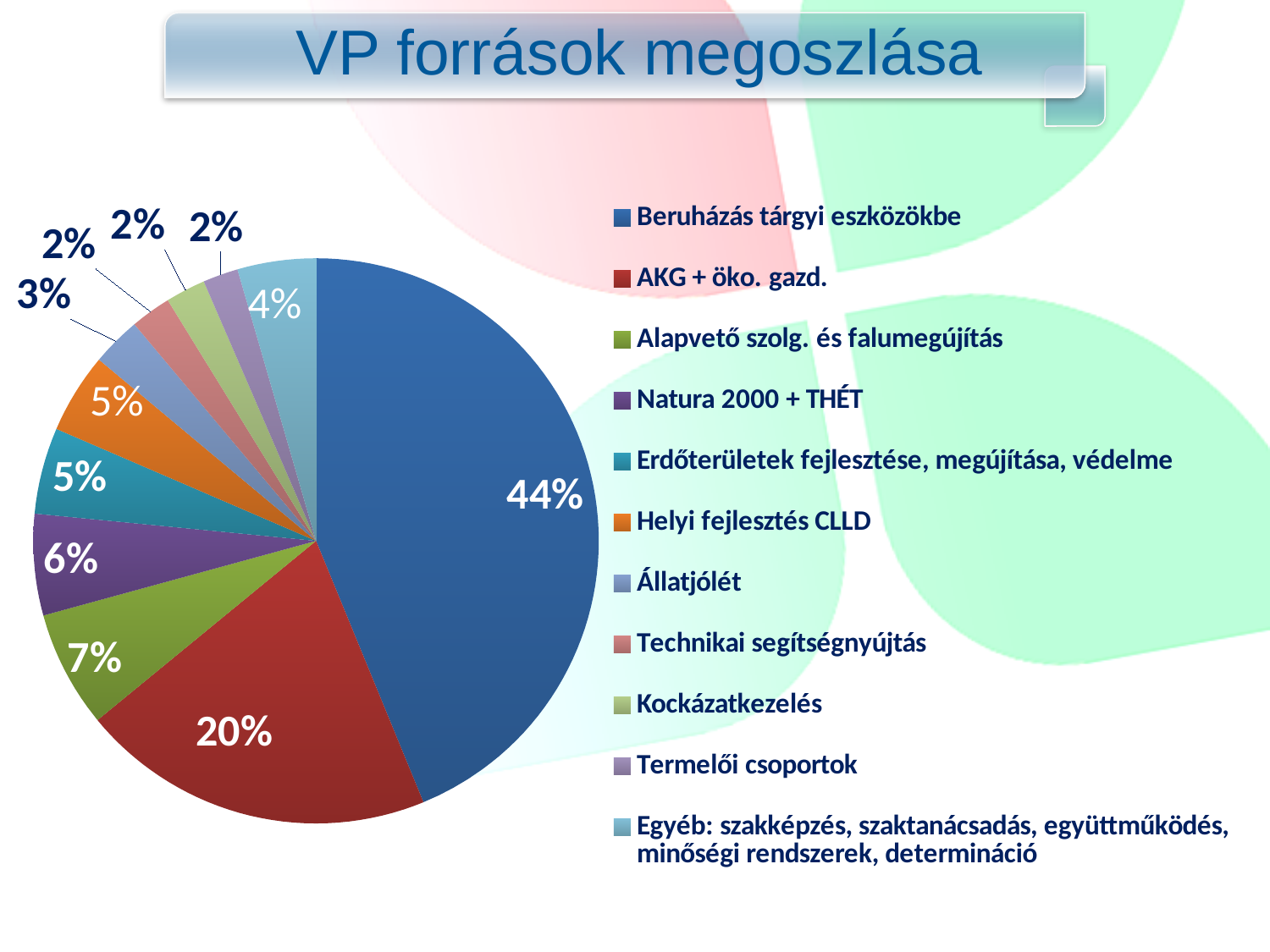
What colour is the slice for 'Helyi fejlesztés CLLD'? orange Which is larger, the share for 'Egyéb: szakképzés, szaktanácsadás, együttműködés, minőségi rendszerek, determináció' or the share for 'Állatjólét'? Egyéb: szakképzés, szaktanácsadás, együttműködés, minőségi rendszerek, determináció What type of chart is shown on the slide? pie chart What is the value for 'AKG + öko. gazd.'? 20% Which category has the largest share of the pie? Beruházás tárgyi eszközökbe What is the value for 'Alapvető szolg. és falumegújítás'? 7% What is the title of the chart? VP források megoszlása What is the difference between the shares of 'Beruházás tárgyi eszközökbe' and 'AKG + öko. gazd.'? 24% What is the value for 'Állatjólét'? 3% What is the value for 'Natura 2000 + THÉT'? 6% What share of the pie does 'Beruházás tárgyi eszközökbe' take? 44% How many categories does the legend list? 11